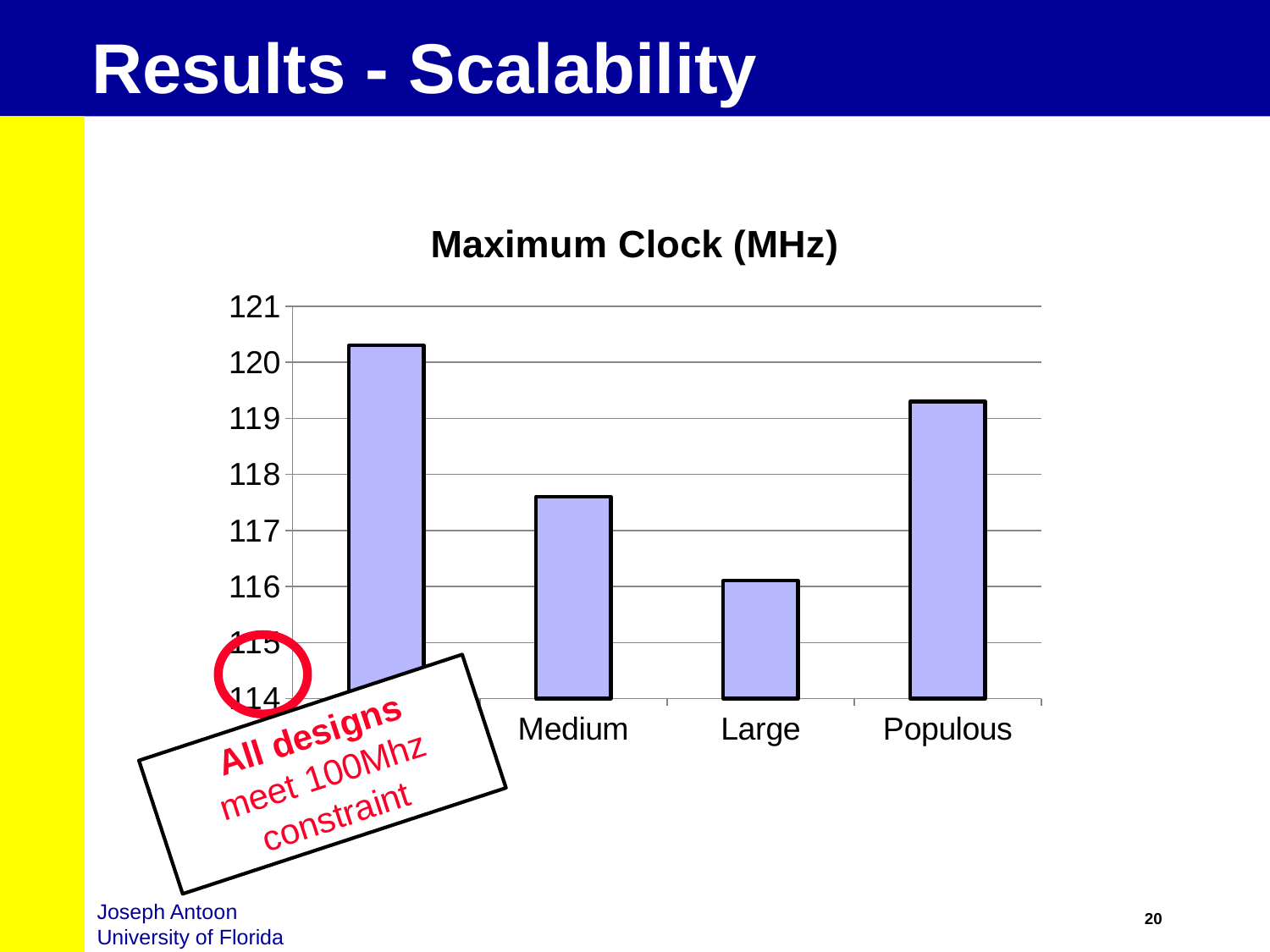
What is the title of the chart? Maximum Clock (MHz) Among Medium, Large and Populous, which category has the highest maximum clock? Populous How many bars are plotted in the chart? 4 What kind of chart is shown on the slide? bar chart Which has a higher maximum clock, Medium or Large? Medium Is the value for Medium greater or less than 118? less Is the value for Populous greater or less than 120? less Which has a higher maximum clock, Populous or Medium? Populous Which category has the lowest maximum clock? Large Is the value for Large greater or less than 117? less What does the rotated annotation box on the slide say? All designs meet 100Mhz constraint